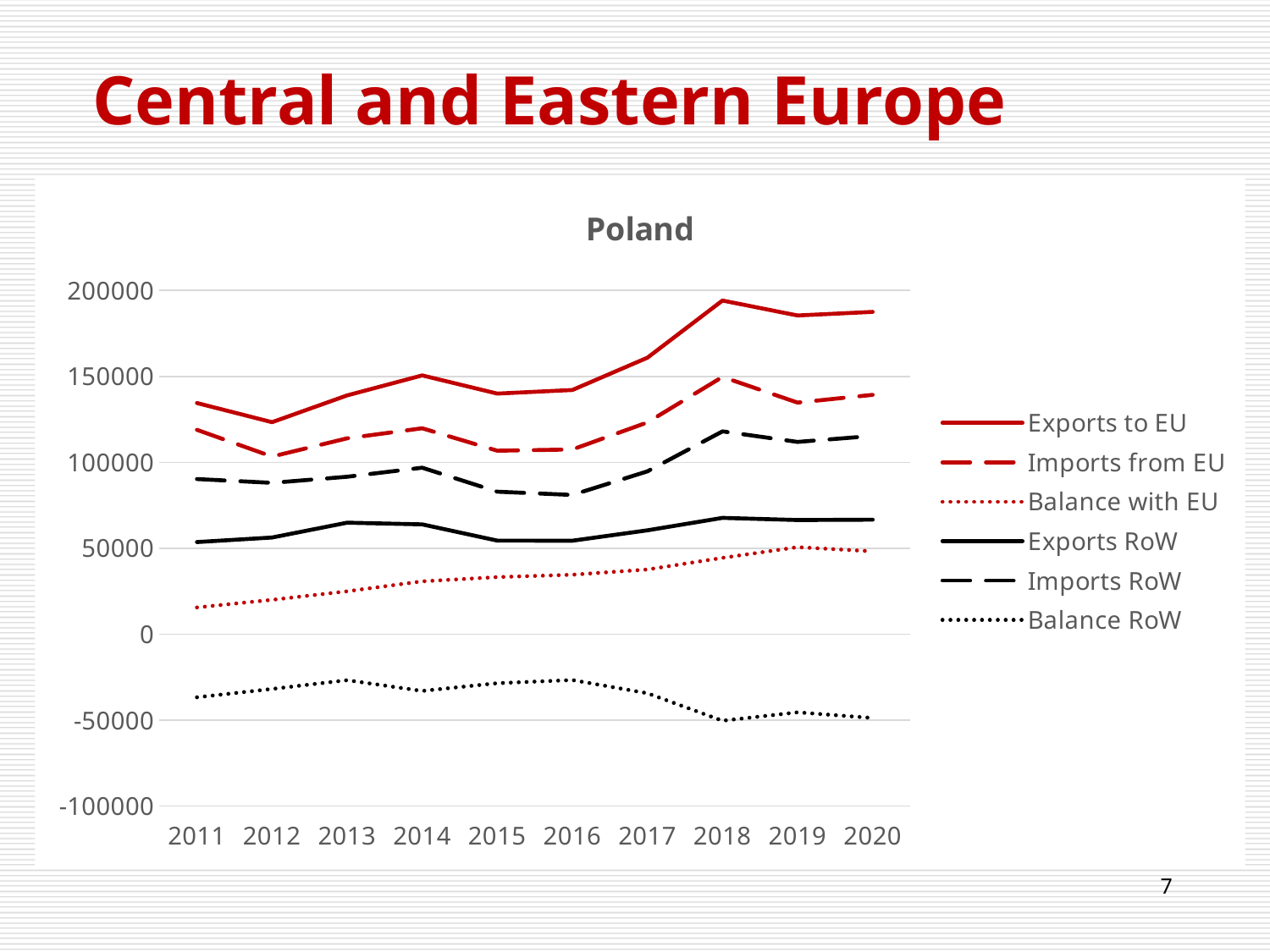
What is the title of the chart? Poland What kind of chart is shown on the slide? Line chart How many years are shown on the x axis? 10 Is the value for Balance with EU in 2011 greater or less than 50000? less Does the Balance with EU series rise or fall from 2011 to 2020? rise Is the value for Imports RoW in 2016 greater or less than 100000? less Which series has the highest value in 2020? Exports to EU How many series does the legend list? 6 In which year does the Exports to EU series reach its highest value? 2018 Which series has the lowest value in 2020? Balance RoW Which is larger in 2018, Exports to EU or Imports from EU? Exports to EU Is the value for Exports to EU in 2018 greater or less than 150000? greater